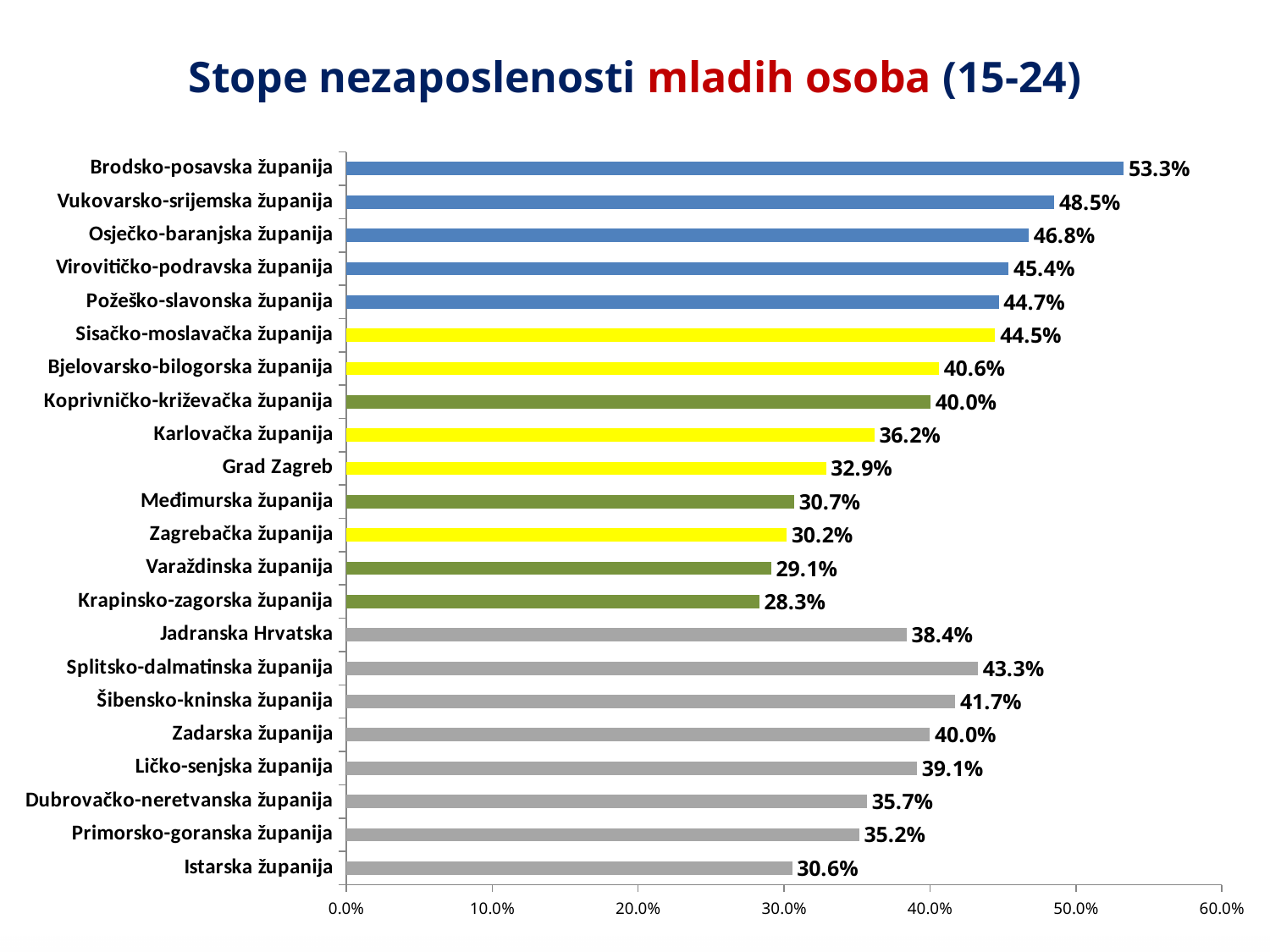
Which category has the highest value on the chart? Brodsko-posavska županija What is the difference between the values for Splitsko-dalmatinska županija and Istarska županija? 12.7% What is the value shown for Grad Zagreb? 32.9% What is the value shown for Jadranska Hrvatska? 38.4% Is the value for Karlovačka županija greater or less than 40.0%? less What kind of chart is shown on the slide? bar chart What is the youth unemployment rate for Brodsko-posavska županija? 53.3% How many categories are shown on the chart? 22 Which is larger, the value for Šibensko-kninska županija or the value for Ličko-senjska županija? Šibensko-kninska županija Which category has the lowest value on the chart? Krapinsko-zagorska županija What is the difference between the values for Brodsko-posavska županija and Vukovarsko-srijemska županija? 4.8% What is the value shown for Istarska županija? 30.6%